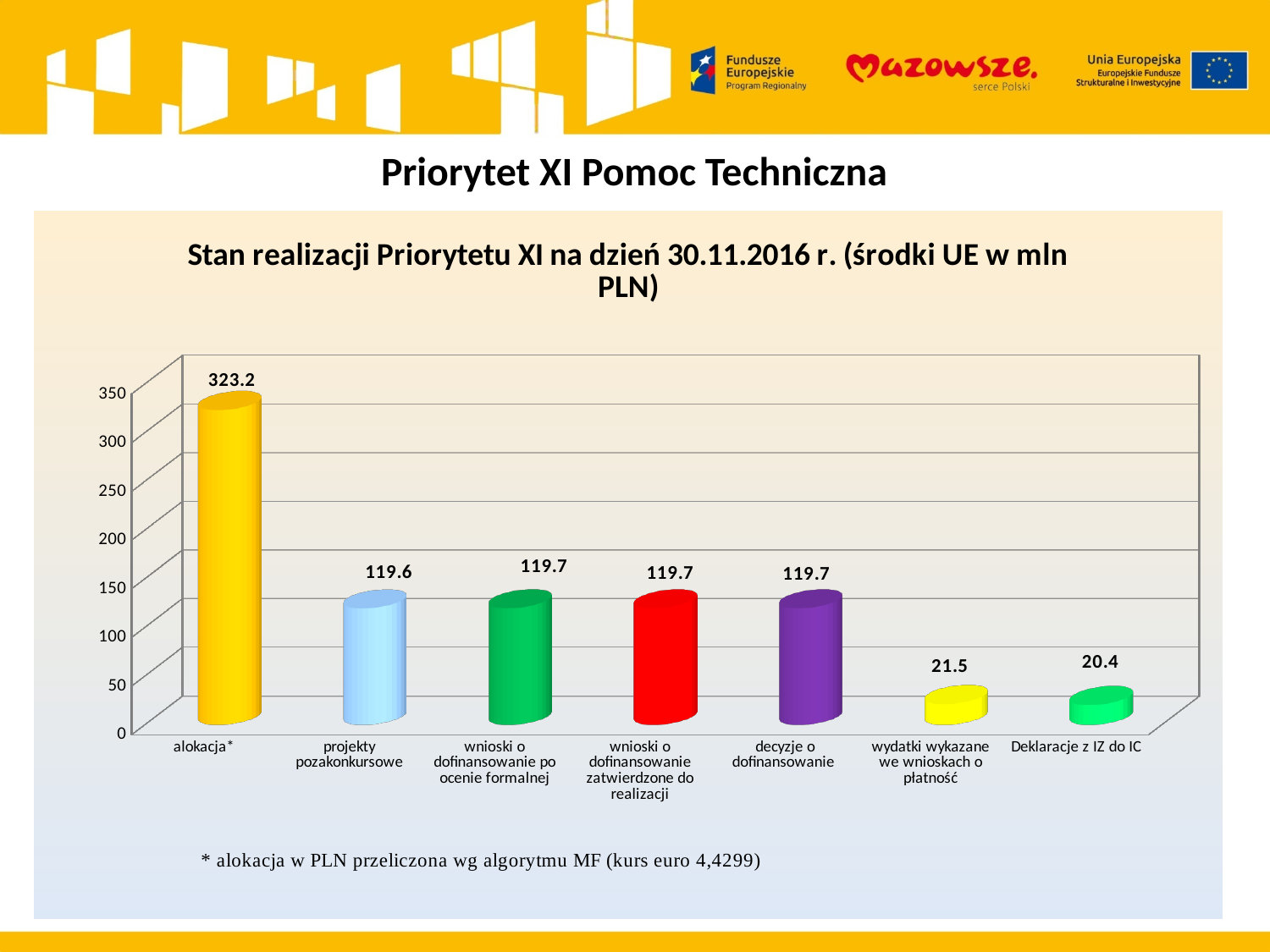
What is the difference between the value for wydatki wykazane we wnioskach o płatność and the value for Deklaracje z IZ do IC? 1.1 Is the value for decyzje o dofinansowanie greater or less than 100? greater What is the difference between the value for alokacja* and the value for decyzje o dofinansowanie? 203.5 What kind of chart is shown on the slide? bar chart What is the value for projekty pozakonkursowe? 119.6 What is the value for wydatki wykazane we wnioskach o płatność? 21.5 Which category has the lowest value? Deklaracje z IZ do IC Which is larger: the value for alokacja* or the value for projekty pozakonkursowe? alokacja* How many categories are shown on the chart? 7 What is the value for alokacja*? 323.2 What is the value for Deklaracje z IZ do IC? 20.4 Which category has the highest value? alokacja*